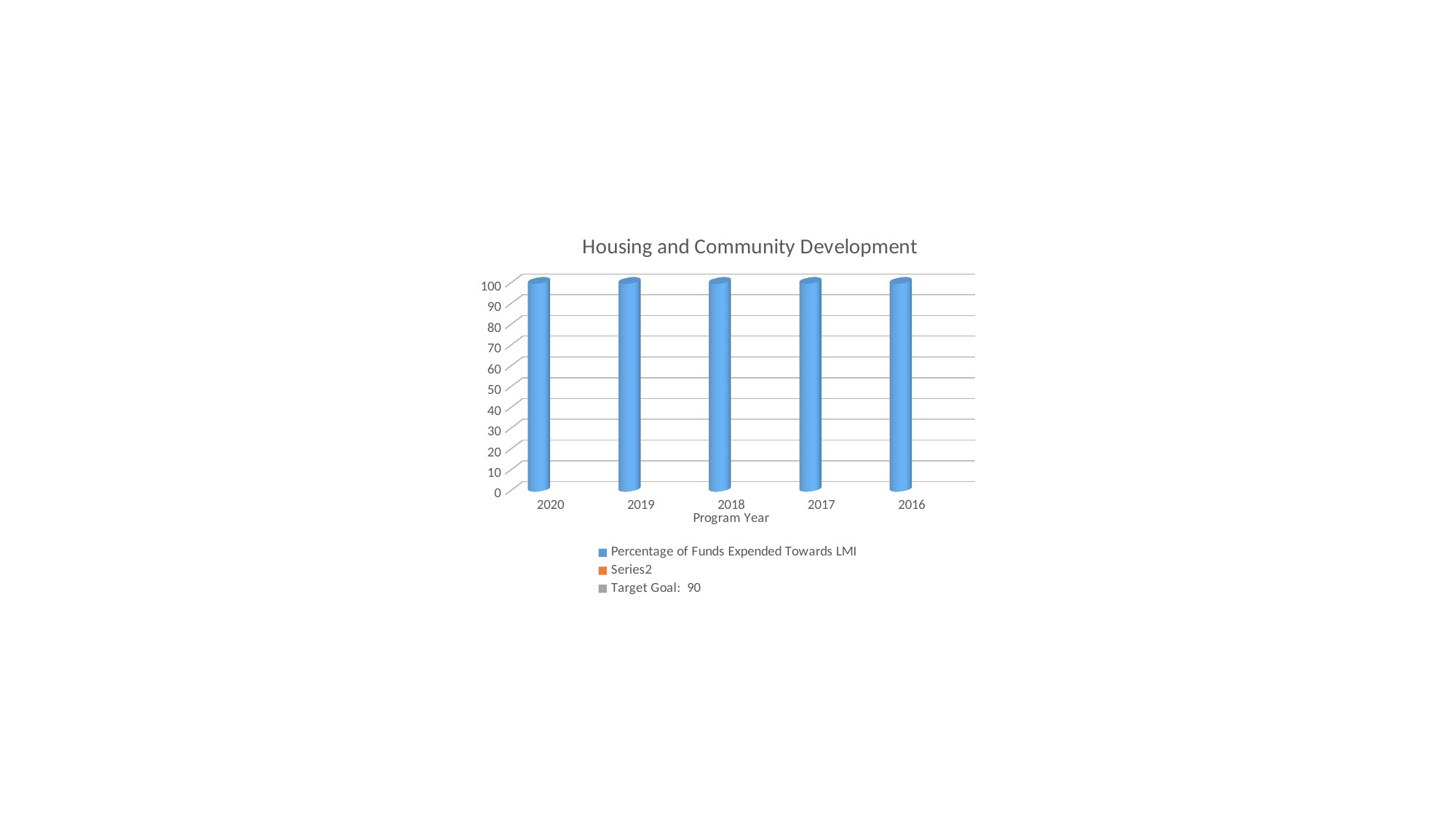
What type of chart is shown on the slide? bar chart What is the difference between the values for 2019 and 2017? 0 How many series does the legend list? 3 Is the value for 2017 greater or less than 50? greater What is the label of the x axis? Program Year Is the value for 2018 greater or less than 90? greater How many program years are shown on the x axis? 5 What is the title of the chart? Housing and Community Development Do the values rise, fall, or stay flat across the program years on the x axis? stay flat What is the Percentage of Funds Expended Towards LMI for program year 2016? 100 What is the Percentage of Funds Expended Towards LMI for program year 2020? 100